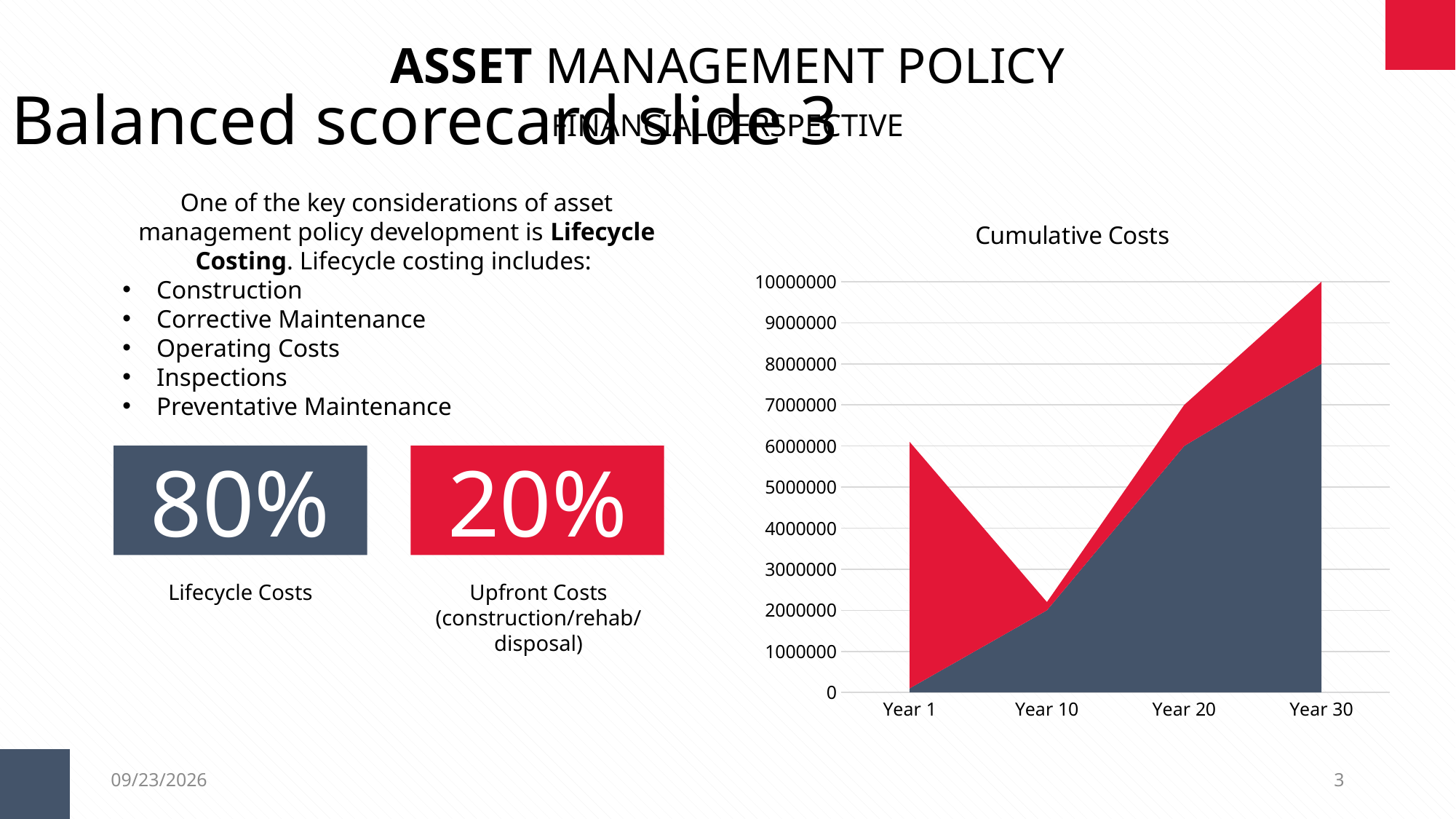
Is the value of the dark blue series at Year 30 greater or less than 7000000? greater Is the top of the stacked area at Year 1 greater or less than 5000000? greater Is the value of the dark blue series at Year 20 greater or less than 5000000? greater Does the dark blue series rise or fall from Year 1 to Year 30? rise What is the title of the chart? Cumulative Costs What kind of chart is shown on the slide? area chart In the Cumulative Costs chart, at which year is the top of the stacked area lowest? Year 10 Which is larger, the top of the stacked area at Year 1 or at Year 10? Year 1 In the Cumulative Costs chart, at which year does the top of the stacked area reach its highest value? Year 30 How many year categories are shown on the x axis of the Cumulative Costs chart? 4